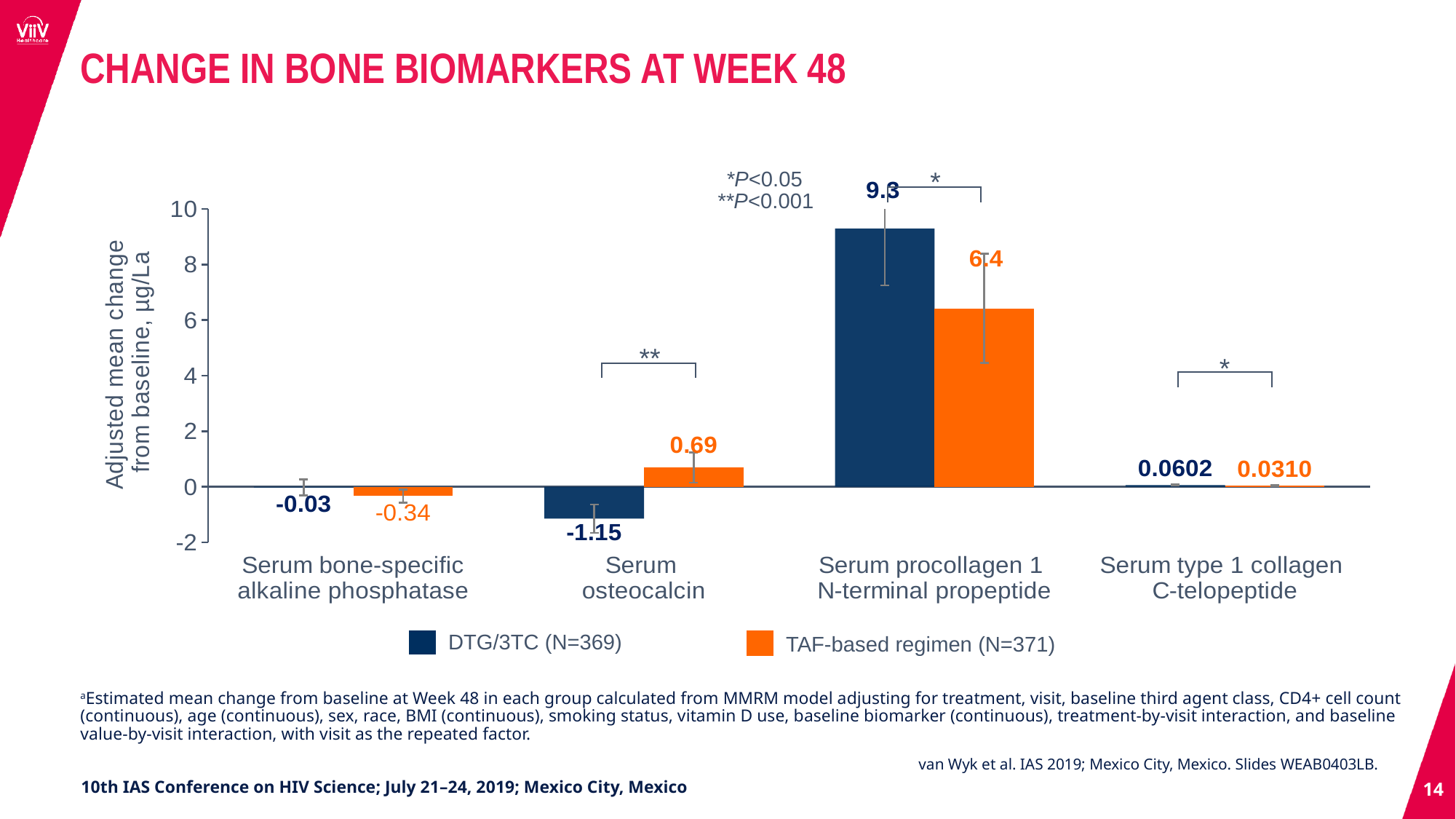
How many biomarker categories are shown on the x axis? 4 For serum osteocalcin, which group has the larger adjusted mean change, DTG/3TC or the TAF-based regimen? TAF-based regimen What type of chart is shown on the slide? Bar chart What is the adjusted mean change for the TAF-based regimen in serum type 1 collagen C-telopeptide? 0.0310 Is the TAF-based regimen value for serum procollagen 1 N-terminal propeptide greater or less than 6? greater What is the adjusted mean change for the TAF-based regimen in serum osteocalcin? 0.69 How many series does the legend list? 2 Which biomarker shows the lowest adjusted mean change for DTG/3TC? Serum osteocalcin What is the difference between the DTG/3TC and TAF-based regimen values for serum procollagen 1 N-terminal propeptide? 2.9 Which biomarker shows the highest adjusted mean change for DTG/3TC? Serum procollagen 1 N-terminal propeptide What is the adjusted mean change for DTG/3TC in serum procollagen 1 N-terminal propeptide? 9.3 What is the adjusted mean change for DTG/3TC in serum bone-specific alkaline phosphatase? -0.03